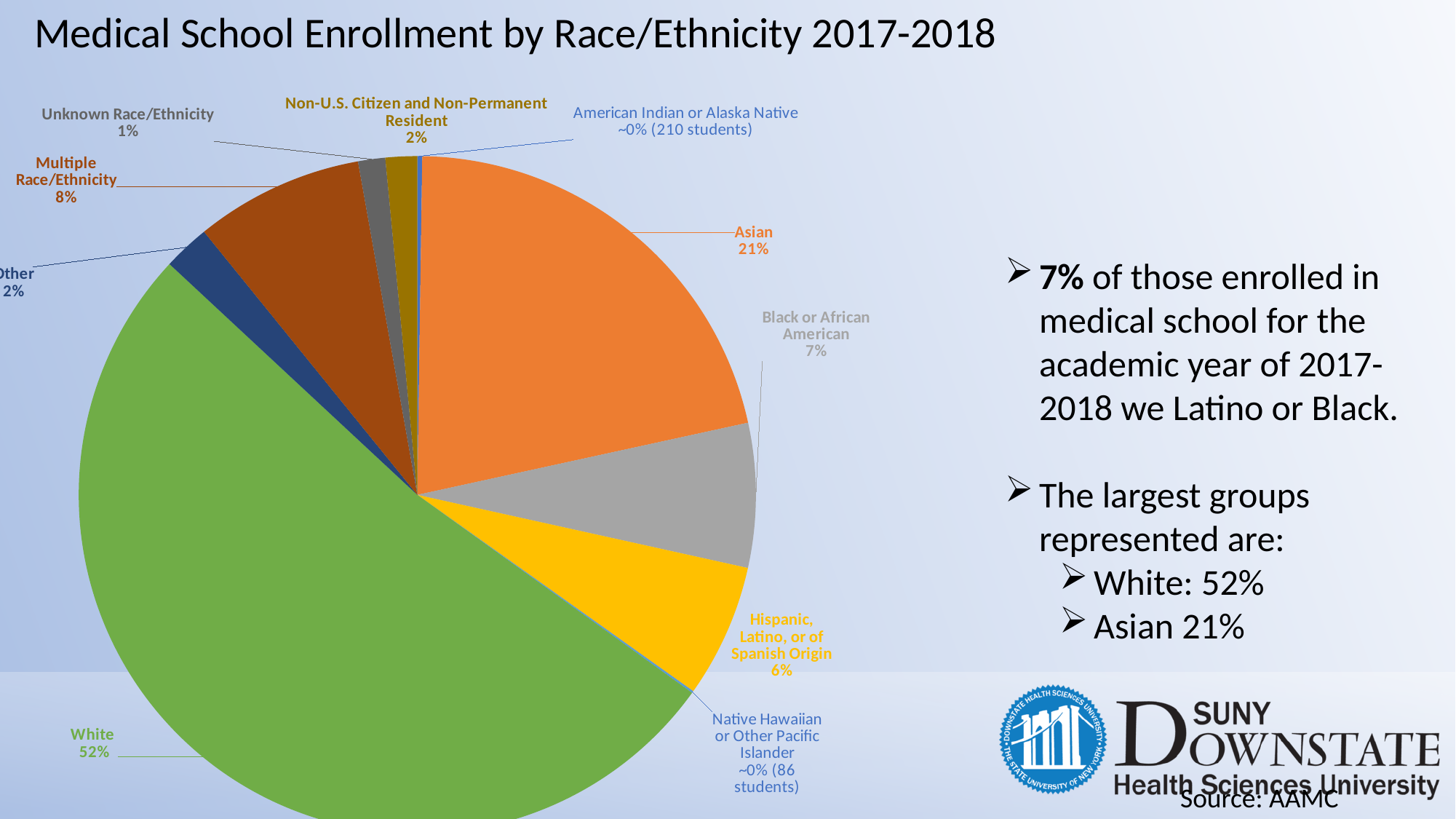
Which race/ethnicity group has the largest share of the pie? White What share of medical school enrollment is Multiple Race/Ethnicity? 8% What share of medical school enrollment is White? 52% How many students are in the Native Hawaiian or Other Pacific Islander group? 86 students What share of medical school enrollment is Hispanic, Latino, or of Spanish Origin? 6% What is the difference in percentage points between the White and Asian shares? 31 What share of medical school enrollment is Unknown Race/Ethnicity? 1% What is the title of the chart? Medical School Enrollment by Race/Ethnicity 2017-2018 What share of medical school enrollment is Black or African American? 7% Which share is larger, Multiple Race/Ethnicity or Black or African American? Multiple Race/Ethnicity What kind of chart is shown on the slide? pie chart What share of medical school enrollment is Asian? 21%